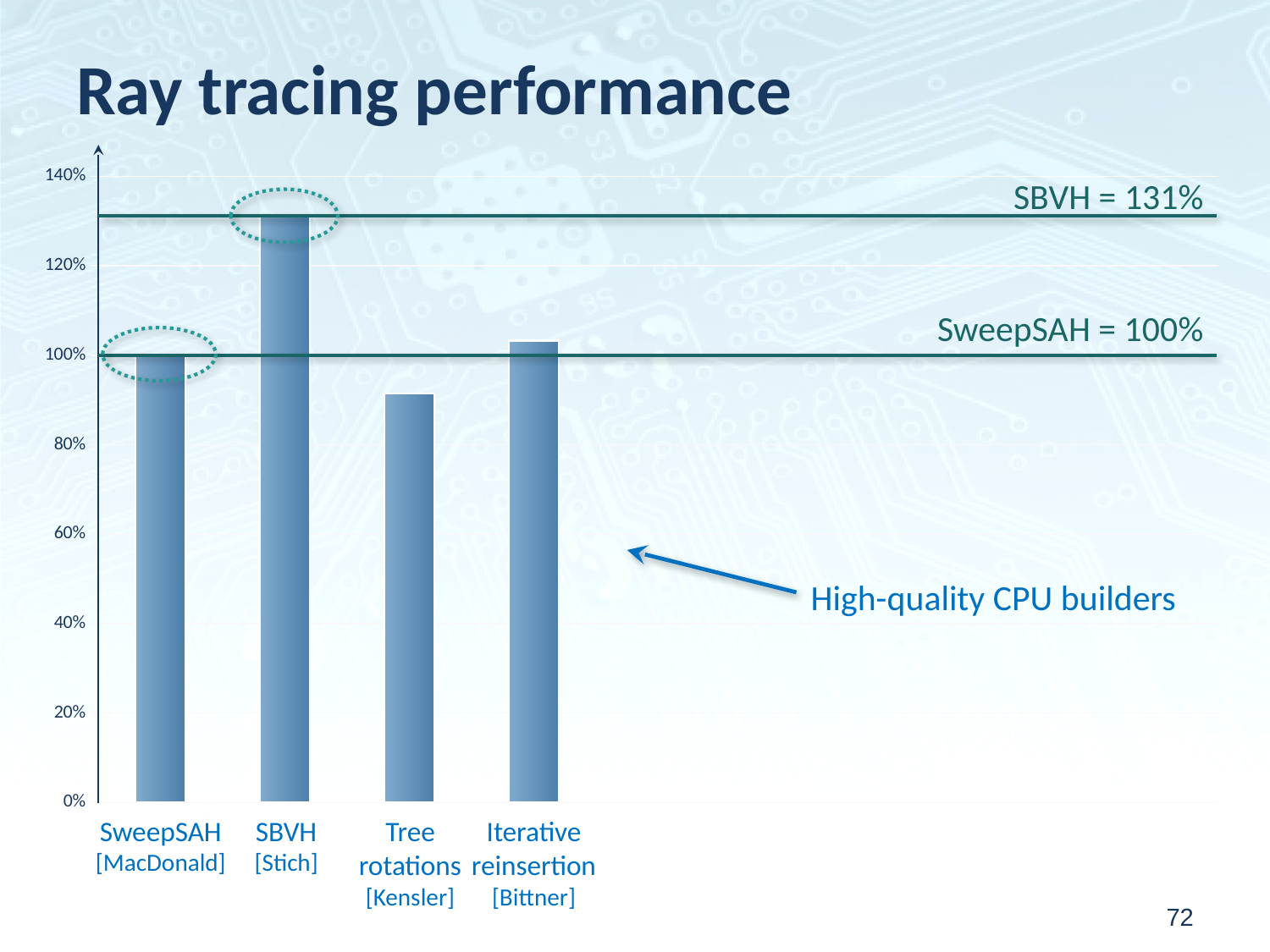
What is the difference between the values for SBVH and SweepSAH? 31% What is the title of the slide? Ray tracing performance Which category has the highest value? SBVH What is the value for SweepSAH? 100% How many categories are shown in the chart? 4 Is the value for Iterative reinsertion greater or less than 120%? less Which is larger, the value for SBVH or the value for Iterative reinsertion? SBVH Which category has the lowest value? Tree rotations What is the value for SBVH? 131% What kind of chart is shown on the slide? bar chart Is the value for Tree rotations greater or less than 100%? less Is the value for Tree rotations greater or less than 80%? greater